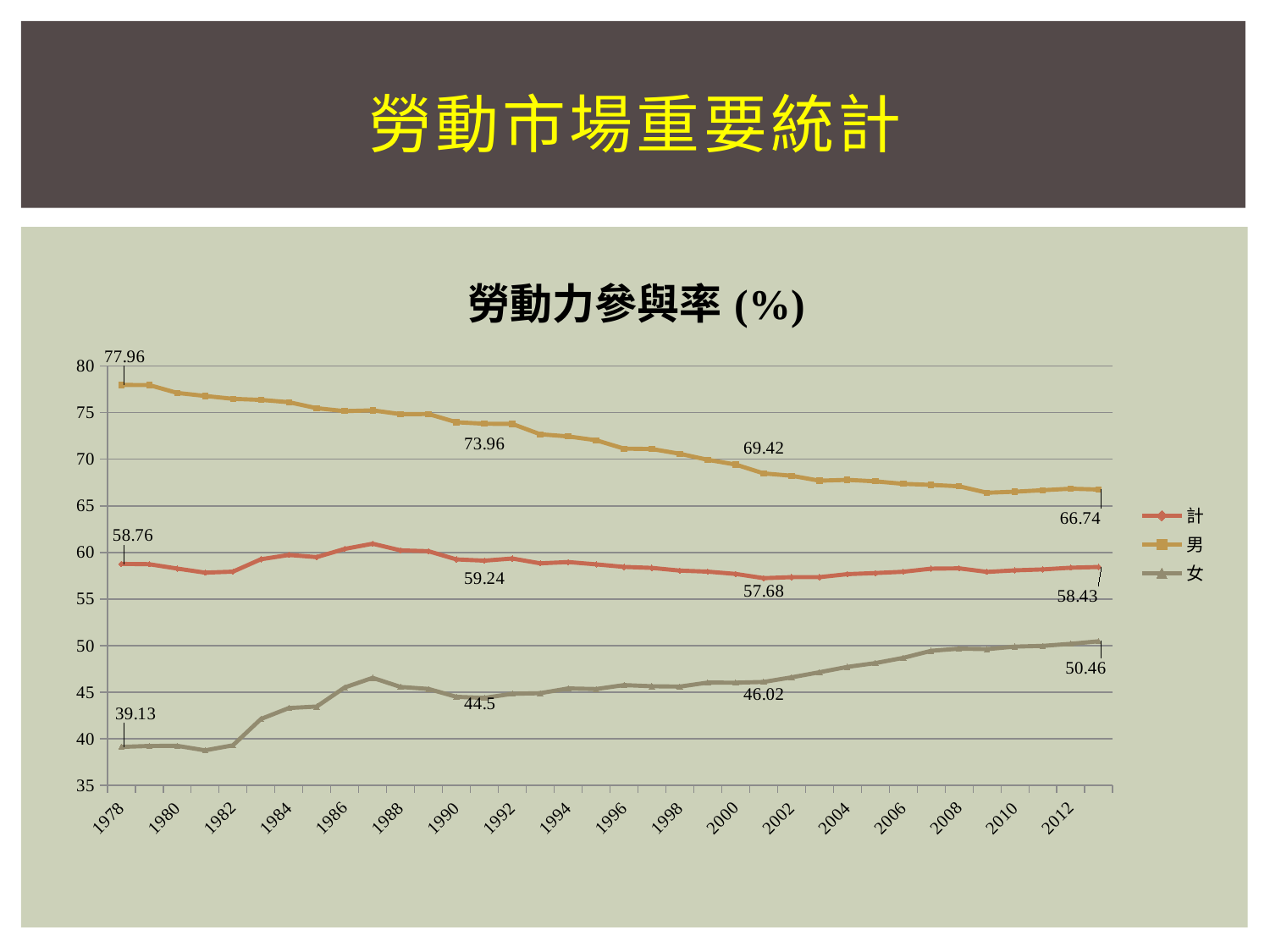
What is the value for 計 in 1978? 58.76 Does the 男 series rise or fall from 1978 to the end of the period? fall What is the title of the chart? 勞動力參與率 (%) What kind of chart is shown on the slide? line chart Does the 女 series rise or fall from 1978 to the end of the period? rise What is the labelled value for 男 at the last data point of the series? 66.74 How many series does the legend list? 3 Is the value for 男 in 1994 greater or less than 70? greater What is the labelled value for 女 at the last data point of the series? 50.46 What is the value for 男 in 1978? 77.96 What is the value for 女 in 1978? 39.13 What is the difference between the 男 and 女 values in 1978? 38.83